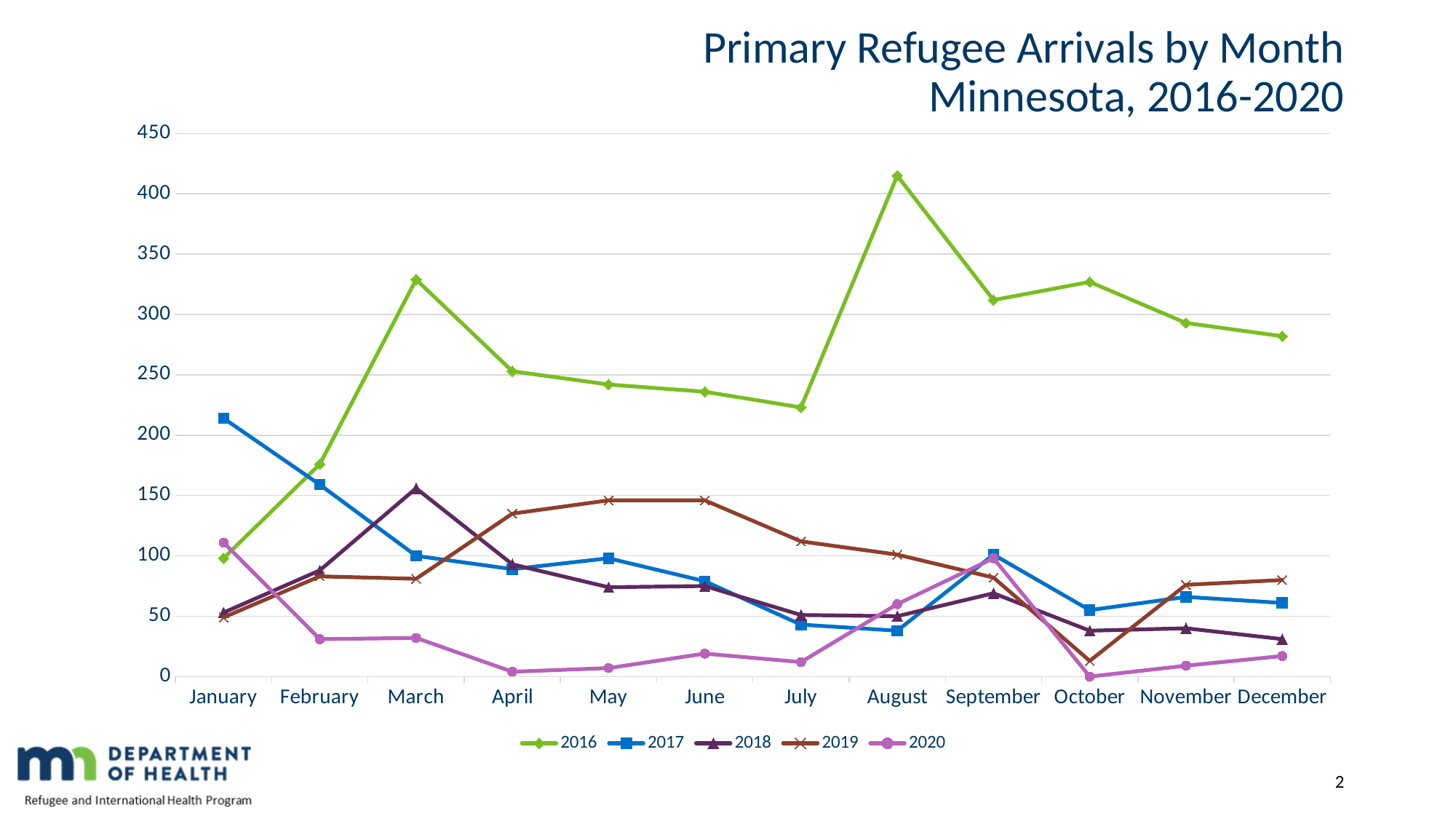
In March, which series has the larger value, 2016 or 2018? 2016 What is the title of the chart? Primary Refugee Arrivals by Month Minnesota, 2016-2020 Does the 2017 series rise or fall from January to March? fall Is the value for 2019 in May greater or less than 100? greater Is the value for 2020 in October greater or less than 50? less Is the value for 2016 in August greater or less than 400? greater How many series does the legend list? 5 How many months are shown along the x axis? 12 In which month was the 2016 series at its lowest value? January In which month did the 2016 series reach its highest value? August What kind of chart is shown on the slide? line chart